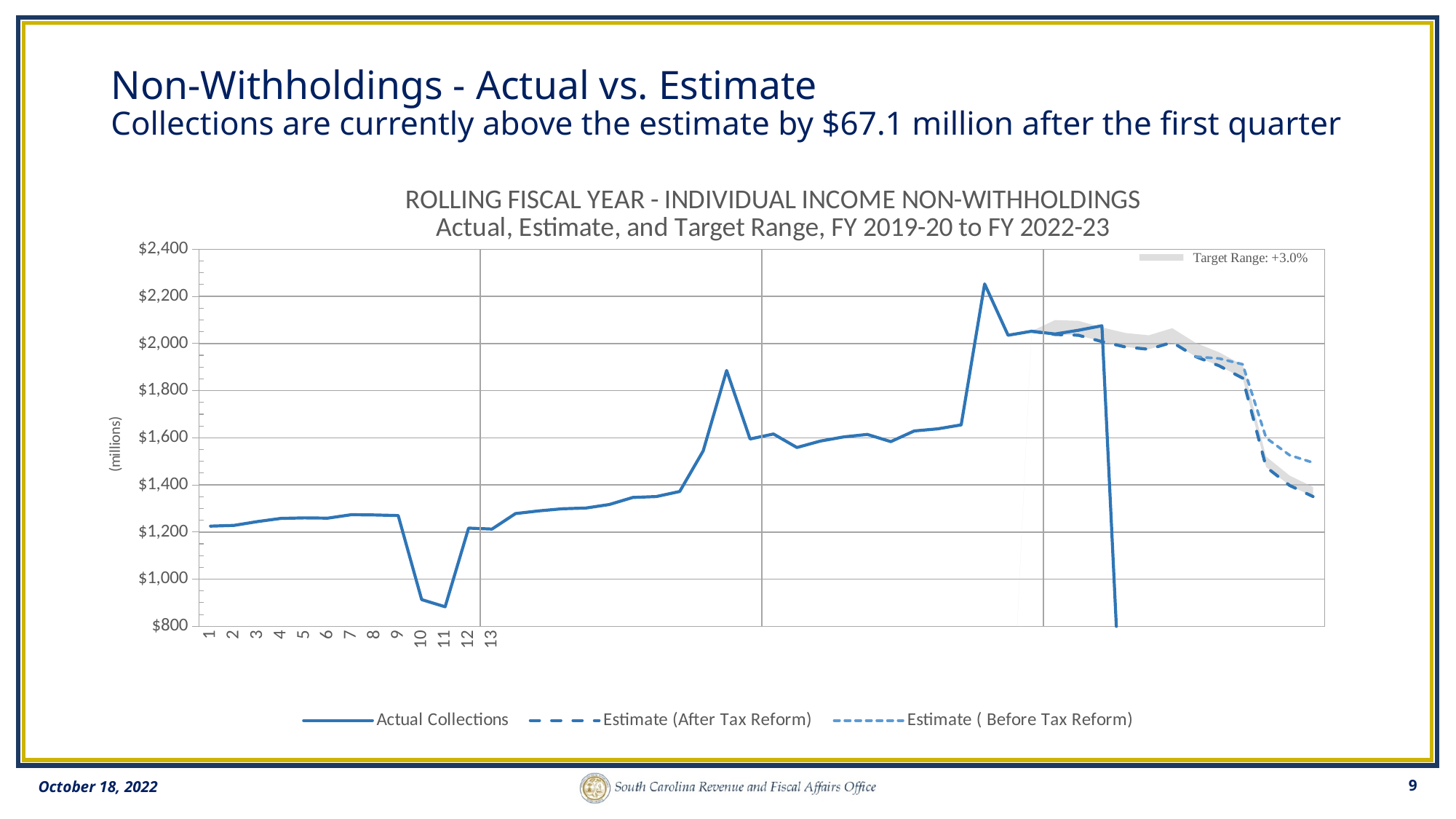
Is the Actual Collections value at point 10 greater or less than $1,000? less How many series does the chart legend list? 3 What unit is shown on the vertical axis label of the chart? (millions) Does the Actual Collections line rise or fall between point 9 and point 11? Fall At the far right end of the chart, which is higher: Estimate (Before Tax Reform) or Estimate (After Tax Reform)? Estimate (Before Tax Reform) Is the Actual Collections value at point 7 greater or less than $1,200? greater What kind of chart is shown on the slide? Line chart At the far right end of the chart, is the Estimate (After Tax Reform) value greater or less than $1,400? less Do the two Estimate lines rise or fall toward the right end of the chart? Fall What percentage is given for the Target Range in the chart legend? +3.0%